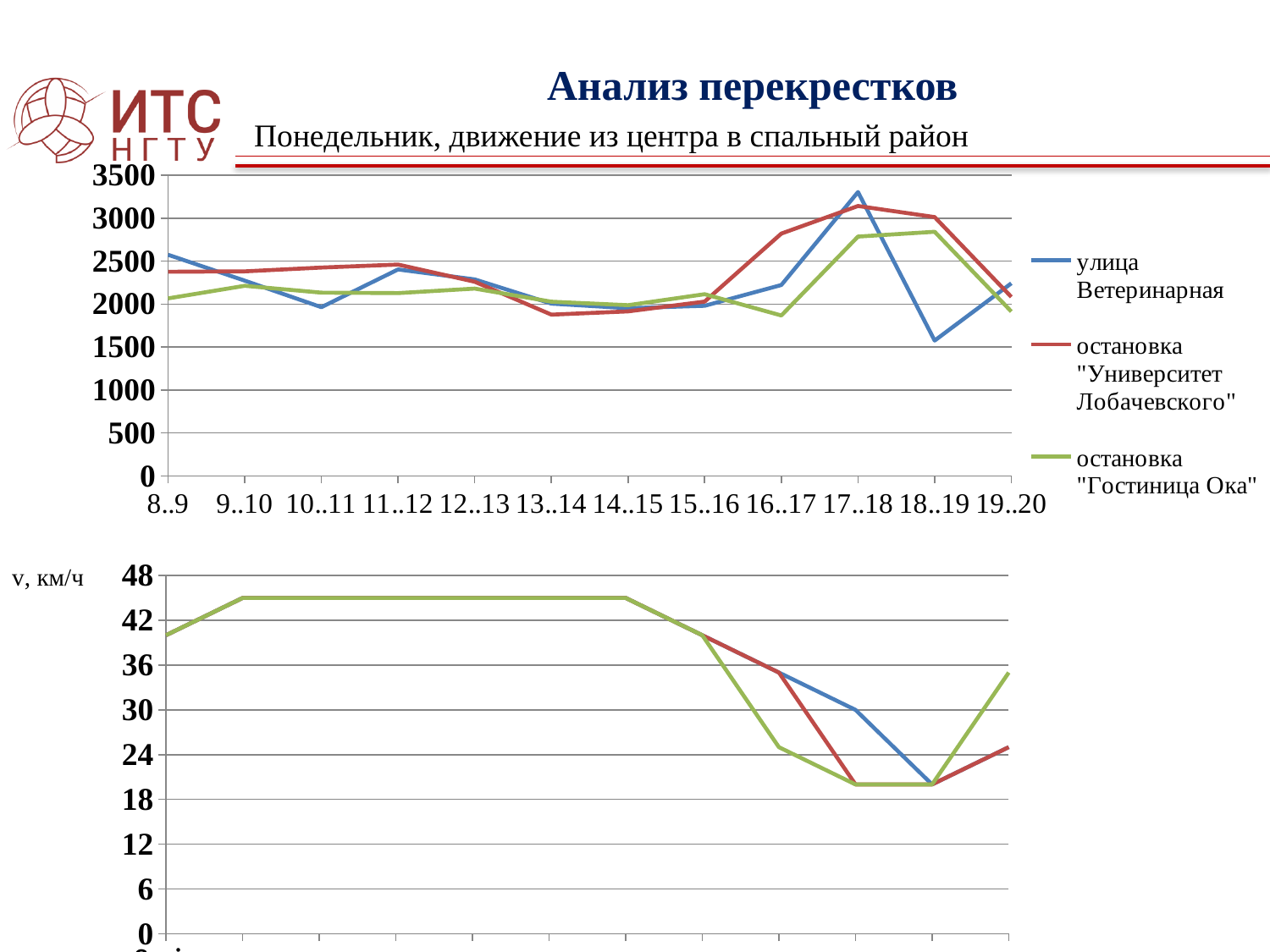
How many series does the legend of the top chart list? 3 In the top chart, at which time interval does улица Ветеринарная reach its highest value? 17..18 In the top chart, at which time interval does улица Ветеринарная reach its lowest value? 18..19 In the top chart, which series has the larger value at 18..19: улица Ветеринарная or остановка "Университет Лобачевского"? остановка "Университет Лобачевского" In the top chart, is the value for остановка "Университет Лобачевского" at 16..17 greater or less than 2500? greater In the top chart, which series has the larger value at 17..18: улица Ветеринарная or остановка "Гостиница Ока"? улица Ветеринарная In the top chart, is the value for улица Ветеринарная at 17..18 greater or less than 3000? greater What kind of chart is the top chart on the slide? line chart How many time intervals are shown on the x axis of the top chart? 12 In the top chart, is the value for улица Ветеринарная at 18..19 greater or less than 2000? less What is the label on the vertical axis of the bottom chart? v, км/ч In the bottom chart, do the values generally rise or fall over the right half of the x axis? fall